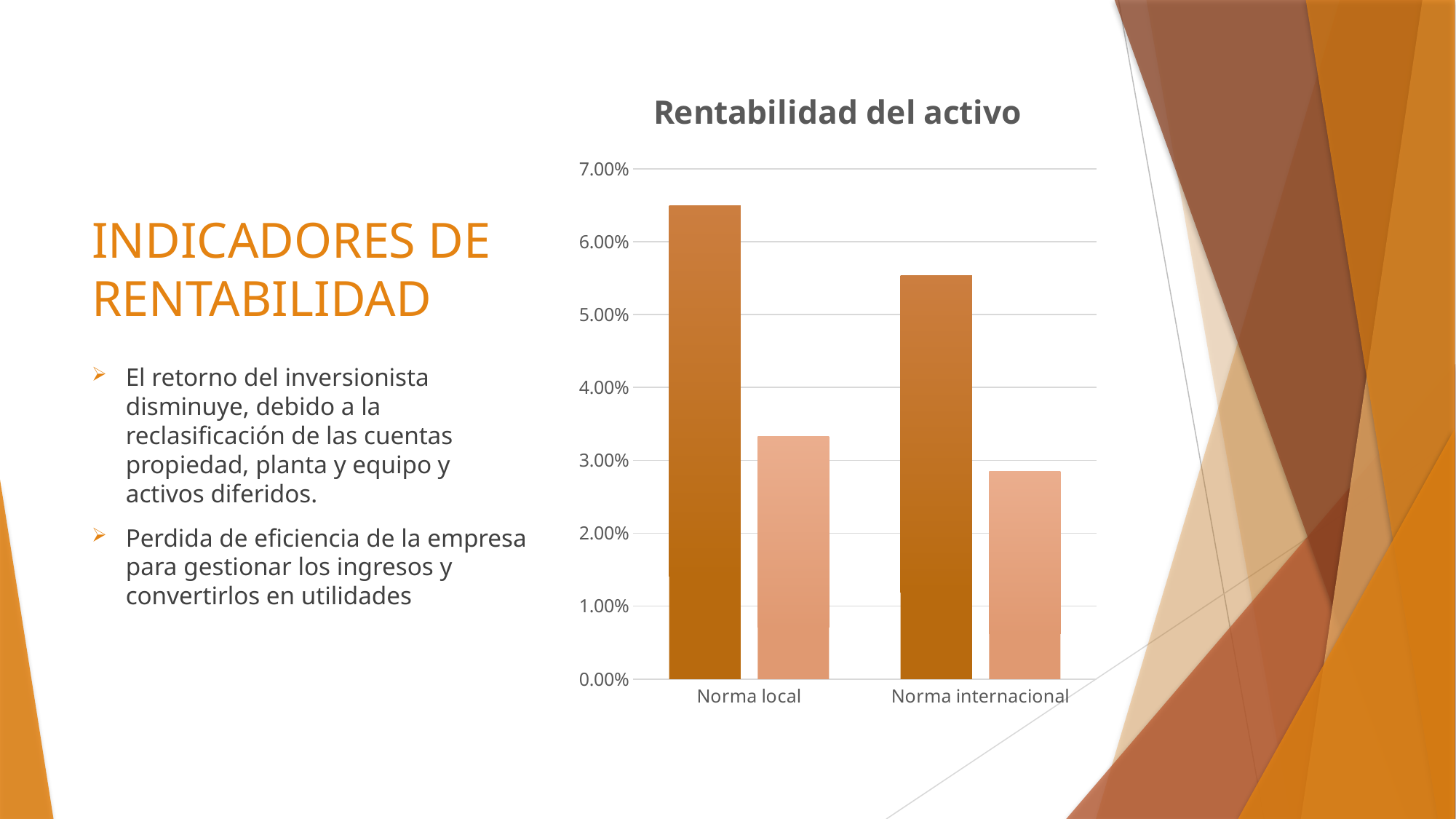
Do the values rise or fall from Norma local to Norma internacional? fall Is the value of the dark brown bar for Norma local greater or less than 6.00%? greater What kind of chart is shown on the slide? bar chart Which category has the tallest bar in the chart? Norma local Which dark brown bar is taller, Norma local or Norma internacional? Norma local Is the value of the dark brown bar for Norma internacional greater or less than 6.00%? less What is the title of the chart? Rentabilidad del activo How many categories are shown on the x axis of the chart? 2 Is the value of the dark brown bar for Norma internacional greater or less than 5.00%? greater Which category has the shortest bar in the chart? Norma internacional